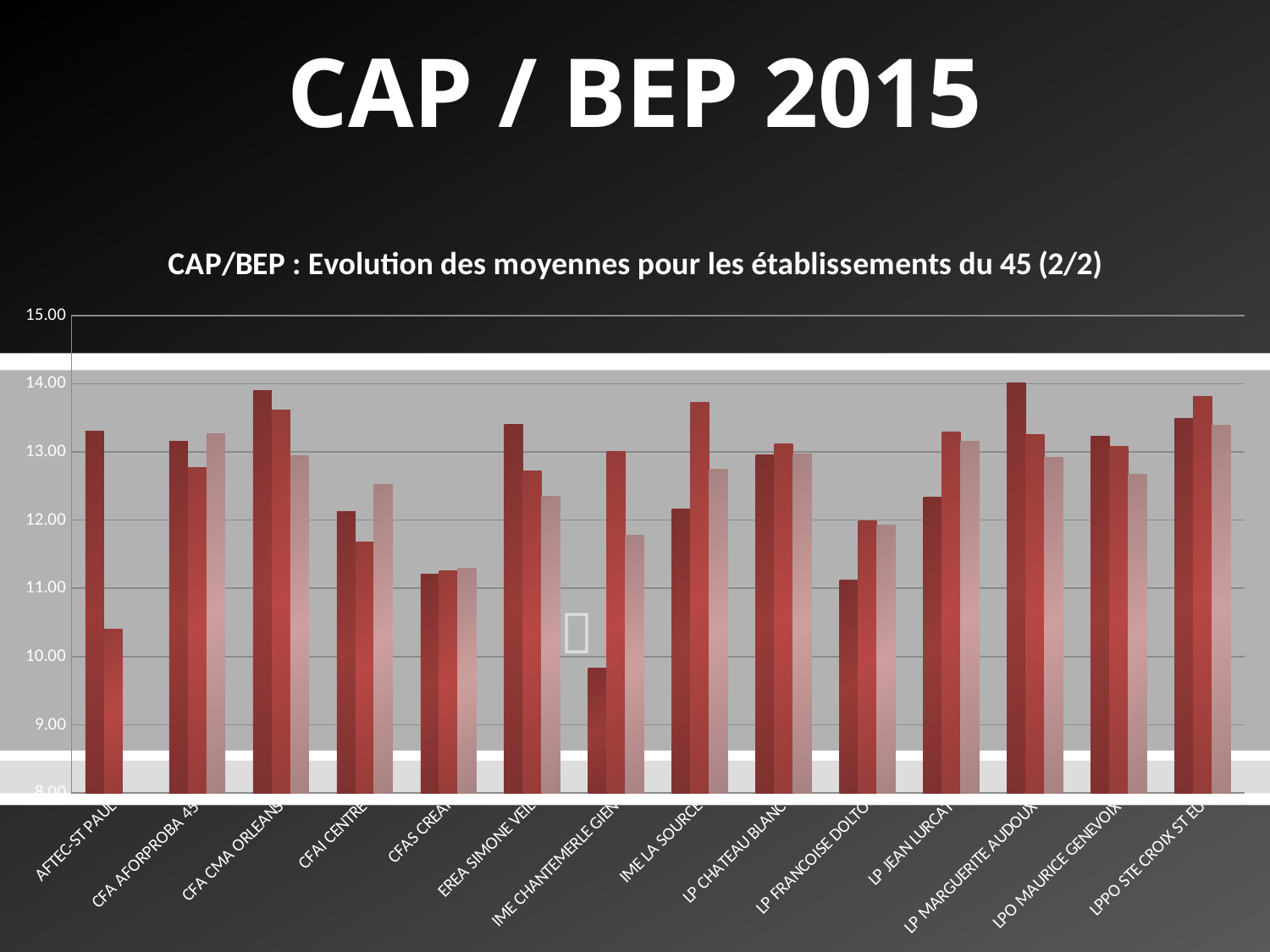
Which establishment has the lowest bar in the chart? IME CHANTEMERLE GIEN Are the bars for CFAS CREA greater or less than 12.00? less Which is taller: the first (darkest) bar for CFA CMA ORLEANS or the first (darkest) bar for CFAS CREA? CFA CMA ORLEANS Is the second bar for IME LA SOURCE greater or less than 13.00? greater Is the first (darkest) bar for EREA SIMONE VEIL greater or less than 13.00? greater For AFTEC-ST PAUL, which is taller: the first bar or the second bar? the first bar What kind of chart is shown on the slide? bar chart How many establishments (categories) are shown on the x axis of the chart? 14 What is the title of the chart? CAP/BEP : Evolution des moyennes pour les établissements du 45 (2/2)